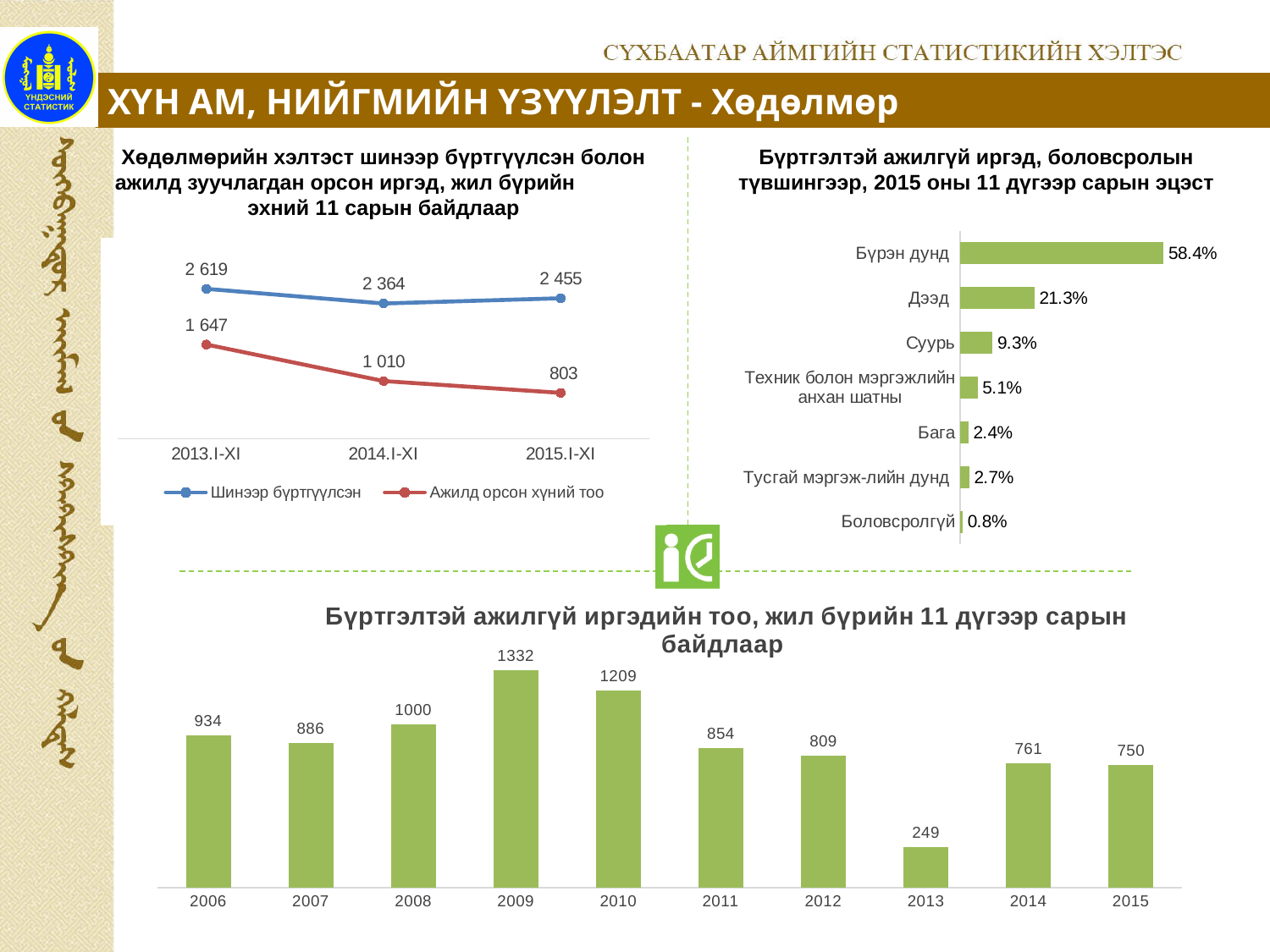
In the bottom bar chart, which year has the highest value? 2009 In the top-left chart, does the Ажилд орсон хүний тоо series rise or fall from 2013.I-XI to 2015.I-XI? fall In the bottom bar chart, what is the value for 2013? 249 How many categories are shown in the top-right bar chart? 7 What kind of chart is the bottom chart on the slide? bar chart In the top-right bar chart, which is larger, Бага or Тусгай мэргэж-лийн дунд? Тусгай мэргэж-лийн дунд In the top-left line chart, what is the value for Ажилд орсон хүний тоо in 2015.I-XI? 803 How many series does the legend of the top-left line chart list? 2 In the top-right bar chart, what is the value for Бүрэн дунд? 58.4% In the top-left line chart, what is the difference between Шинээр бүртгүүлсэн and Ажилд орсон хүний тоо in 2014.I-XI? 1 354 In the top-right bar chart, which category has the lowest value? Боловсролгүй In the top-left line chart, what is the value for Шинээр бүртгүүлсэн in 2013.I-XI? 2 619